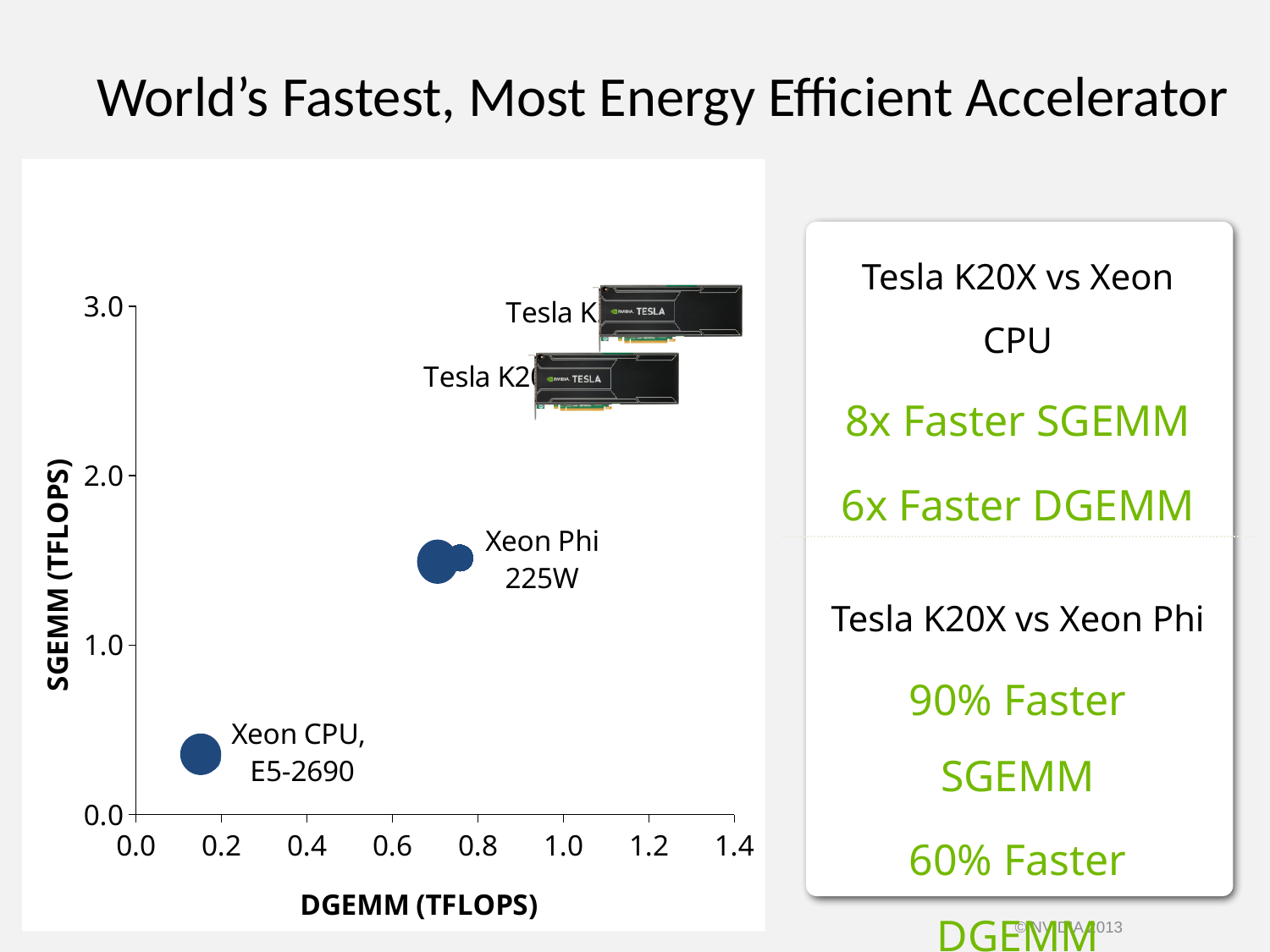
What is the title of the y axis of the chart? SGEMM (TFLOPS) Which has the higher SGEMM value, Xeon Phi 225W or Xeon CPU E5-2690? Xeon Phi 225W Which has the higher DGEMM value, Xeon CPU E5-2690 or Xeon Phi 225W? Xeon Phi 225W Is the SGEMM value for Xeon Phi 225W greater or less than 1.0 TFLOPS? greater Is the DGEMM value for Xeon Phi 225W greater or less than 0.6 TFLOPS? greater Is the SGEMM value for Xeon Phi 225W greater or less than 2.0 TFLOPS? less Which labeled point has the lowest SGEMM value on the chart? Xeon CPU, E5-2690 What is the highest tick value shown on the y axis of the chart? 3.0 What is the title of the x axis of the chart? DGEMM (TFLOPS) What kind of chart is shown on the slide? scatter chart